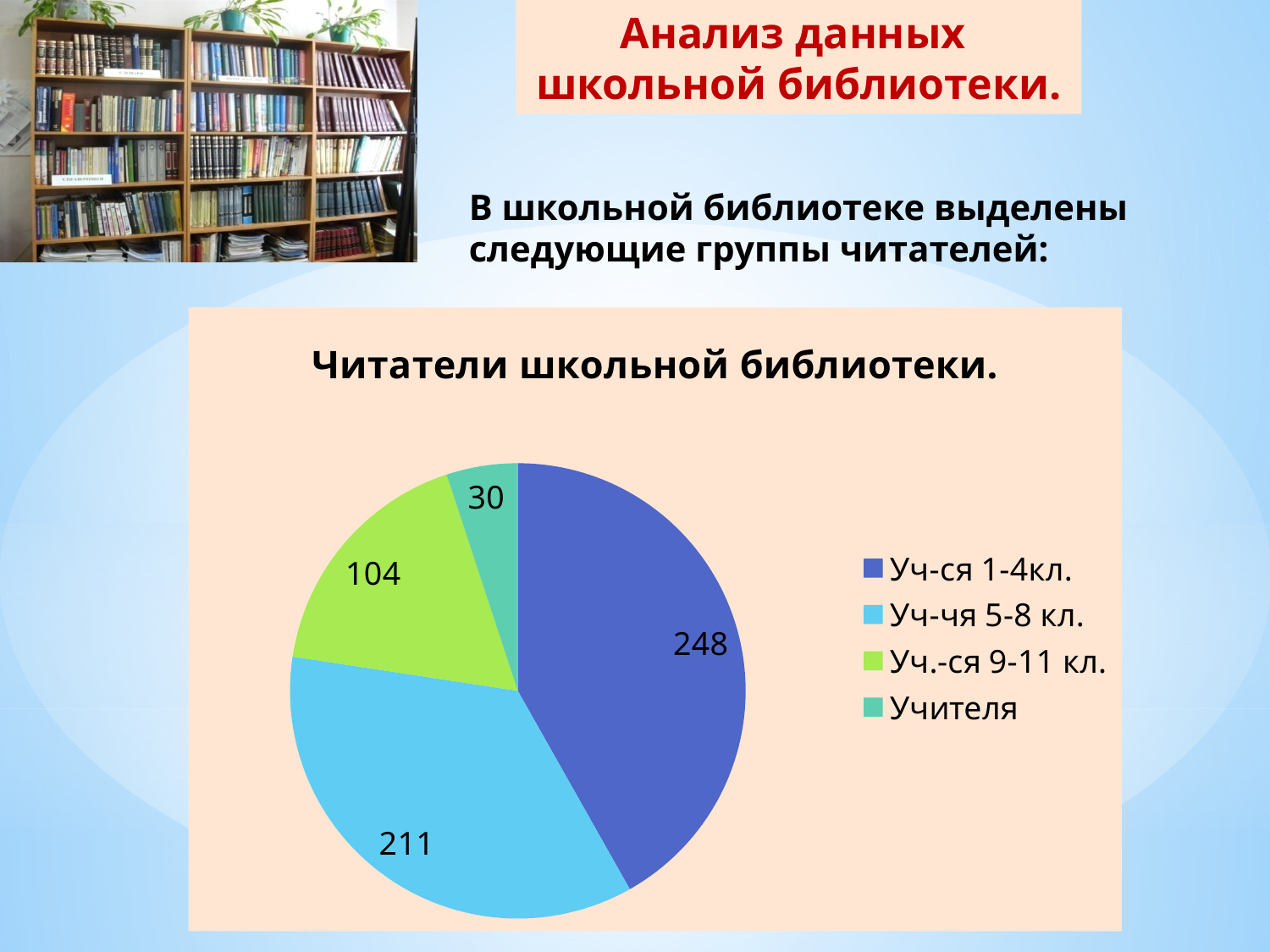
What is the title of the chart? Читатели школьной библиотеки. What type of chart is shown on the slide? pie chart What is the value for Уч.-ся 9-11 кл.? 104 Which is larger, the value for Уч.-ся 9-11 кл. or the value for Учителя? Уч.-ся 9-11 кл. What is the value for Уч-ся 1-4кл.? 248 What is the value for Учителя? 30 Which group of readers has the largest slice? Уч-ся 1-4кл. What is the value for Уч-чя 5-8 кл.? 211 What is the total of all four slices in the pie chart? 593 What is the difference between the values for Уч-ся 1-4кл. and Уч-чя 5-8 кл.? 37 How many groups of readers does the legend list? 4 Which group of readers has the smallest slice? Учителя